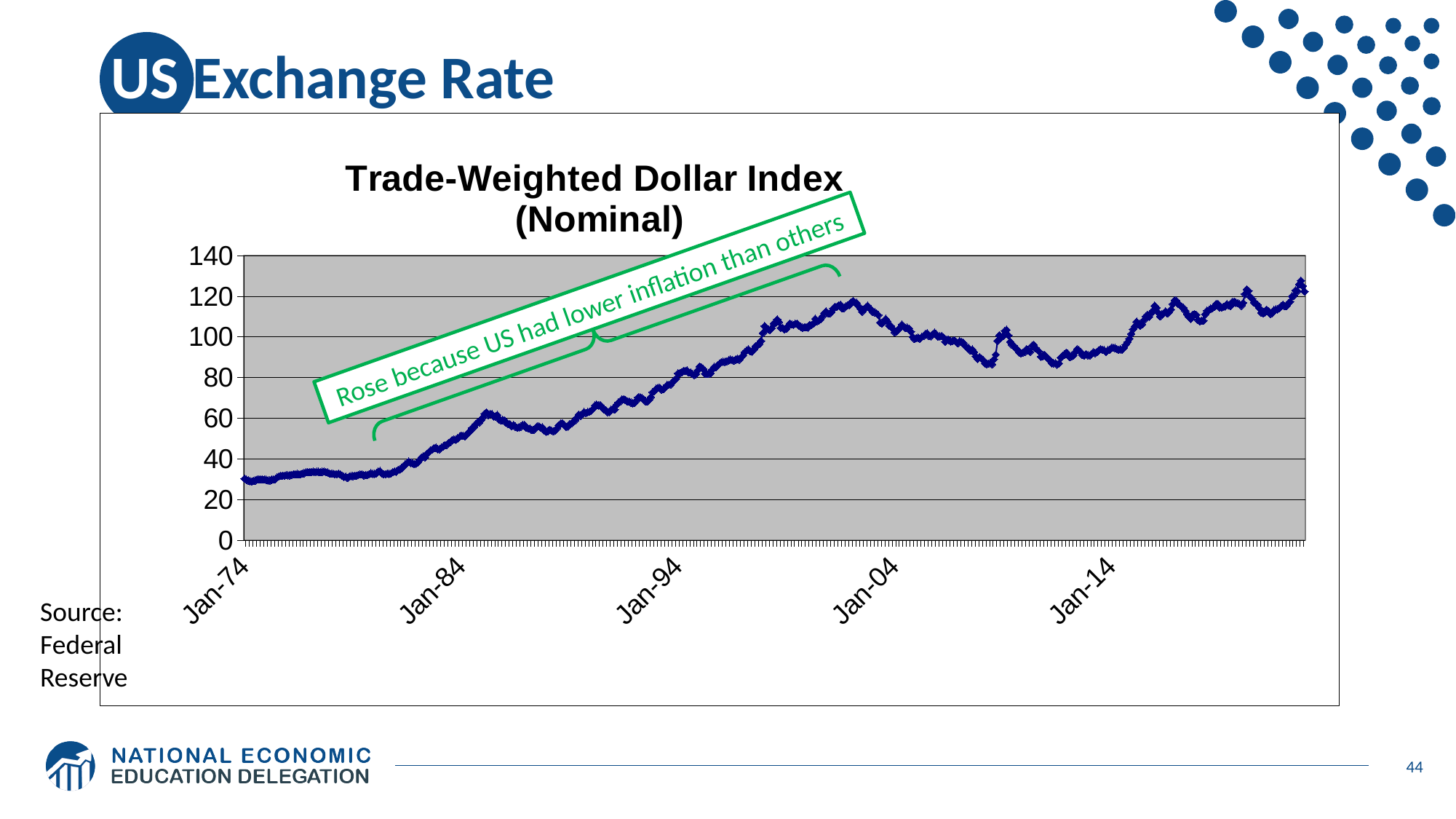
What does the green annotation on the chart say? Rose because US had lower inflation than others What kind of chart is shown on the slide? Line chart Is the value of the index at Jan-04 greater or less than 80? greater Is the value of the index at Jan-94 greater or less than 60? greater Overall, does the index rise or fall from Jan-74 to the end of the series? rise Is the value of the index at Jan-14 greater or less than 100? less How many date labels are shown on the x axis? 5 Does the index rise or fall between Jan-74 and Jan-84? rise What is the title of the chart? Trade-Weighted Dollar Index (Nominal)